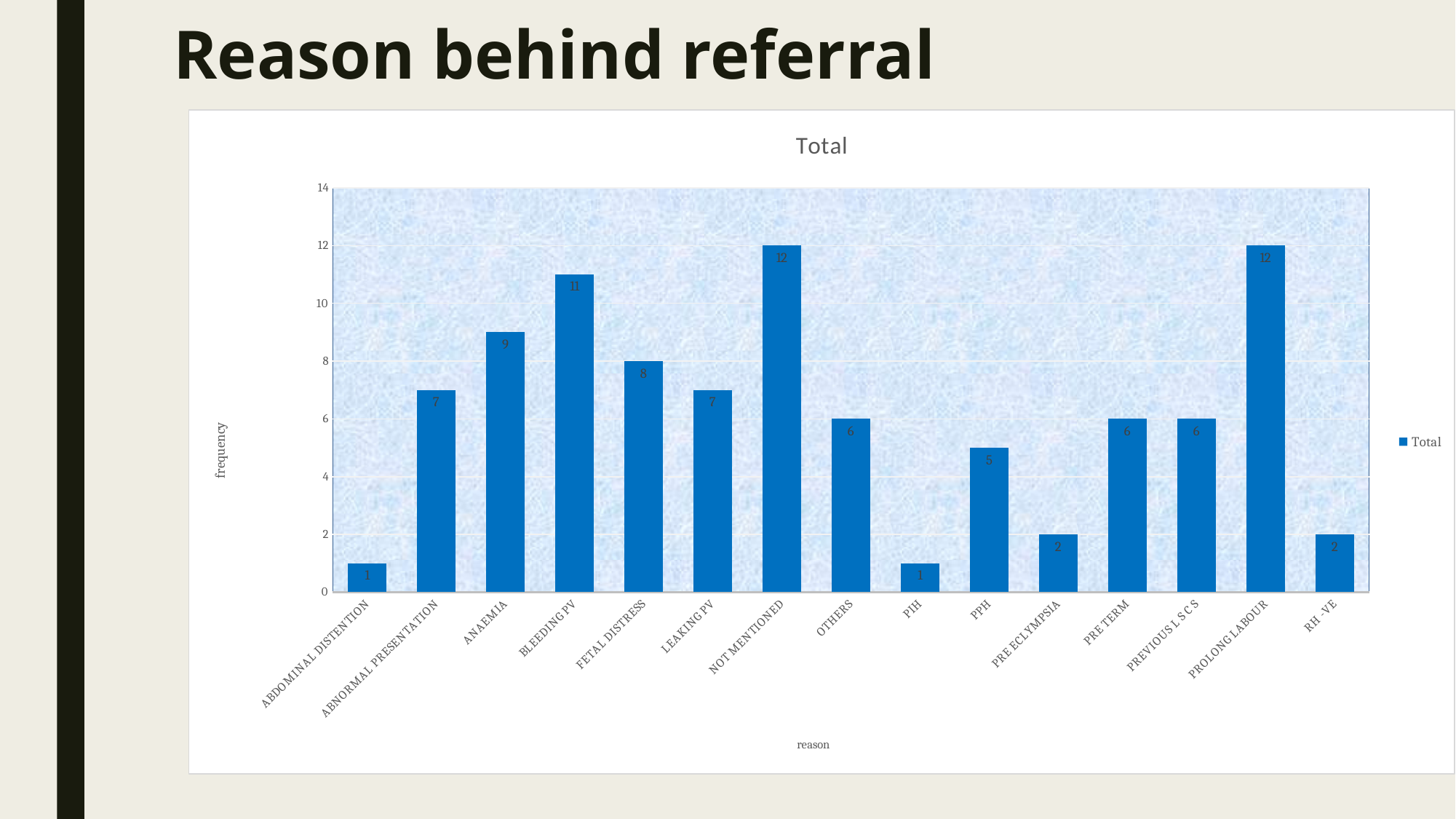
What kind of chart is shown? bar chart What is the value for FETAL DISTRESS? 8 What is the value for PPH? 5 What is the value for BLEEDING PV? 11 What is the value for ANAEMIA? 9 What is the label of the y axis? frequency What is the value for PRE ECLYMPSIA? 2 Which is larger, the value for ANAEMIA or the value for LEAKING PV? ANAEMIA Is the value for BLEEDING PV greater or less than 10? greater How many categories are shown on the x axis? 15 What is the difference between the values for NOT MENTIONED and OTHERS? 6 How many series does the legend list? 1